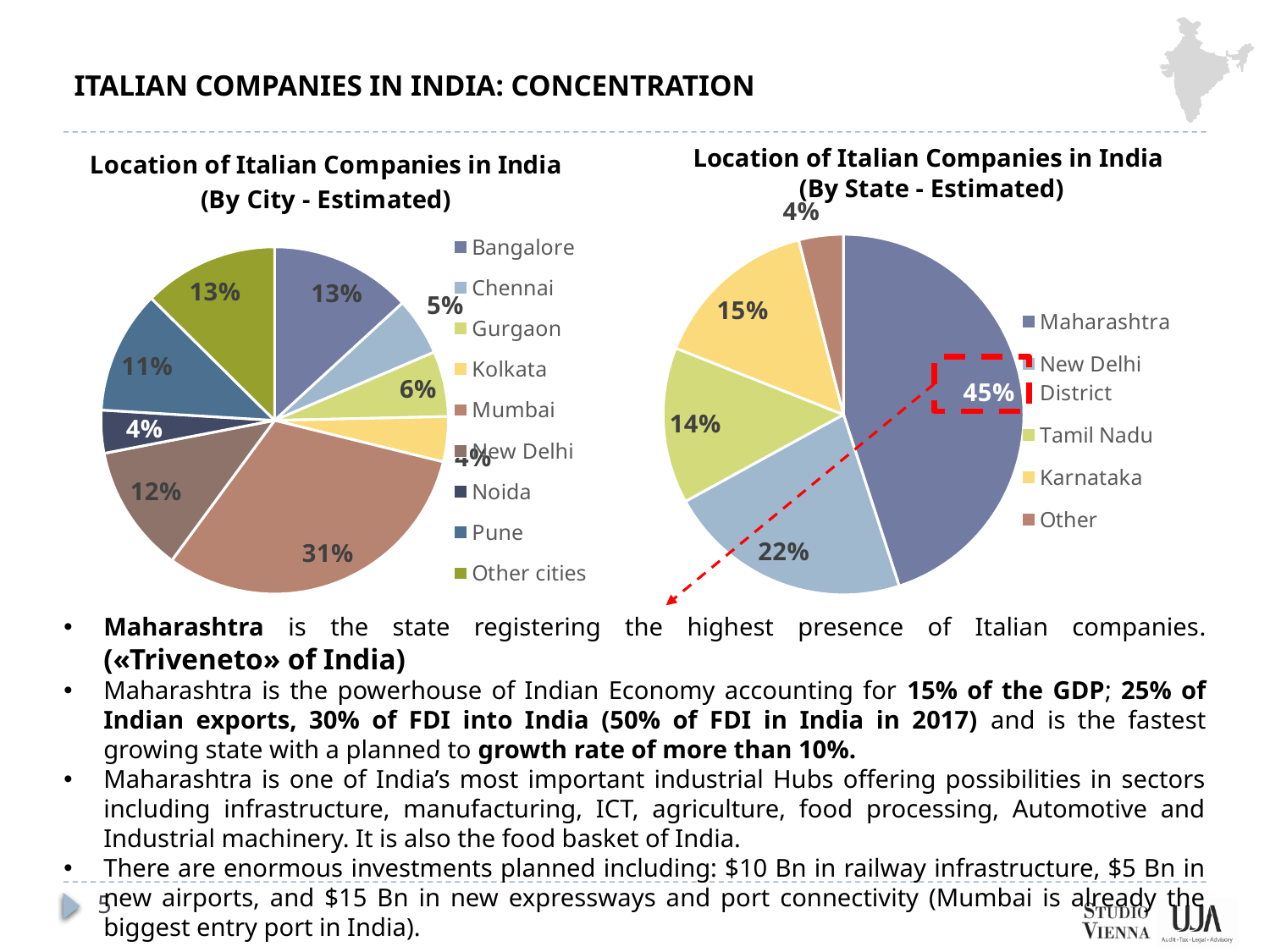
In the 'By City - Estimated' pie chart, what share is Pune? 11% In the 'By State - Estimated' pie chart, what share is New Delhi District? 22% How many slices does the 'By State - Estimated' pie chart have? 5 In the 'By City - Estimated' pie chart, which city has the largest share? Mumbai In the 'Location of Italian Companies in India (By State - Estimated)' chart, what share is Maharashtra? 45% What type of chart is used for 'Location of Italian Companies in India (By State - Estimated)'? Pie chart In the 'By City - Estimated' pie chart, which is larger, the share of Chennai or the share of Gurgaon? Gurgaon In the 'Location of Italian Companies in India (By City - Estimated)' chart, what share is Mumbai? 31% In the 'By City - Estimated' pie chart, what is the difference between the shares of Mumbai and New Delhi? 19% How many entries does the legend of the 'By City - Estimated' pie chart list? 9 In the 'By State - Estimated' pie chart, what is the difference between the shares of Karnataka and Tamil Nadu? 1% In the 'By State - Estimated' pie chart, which state has the smallest share? Other